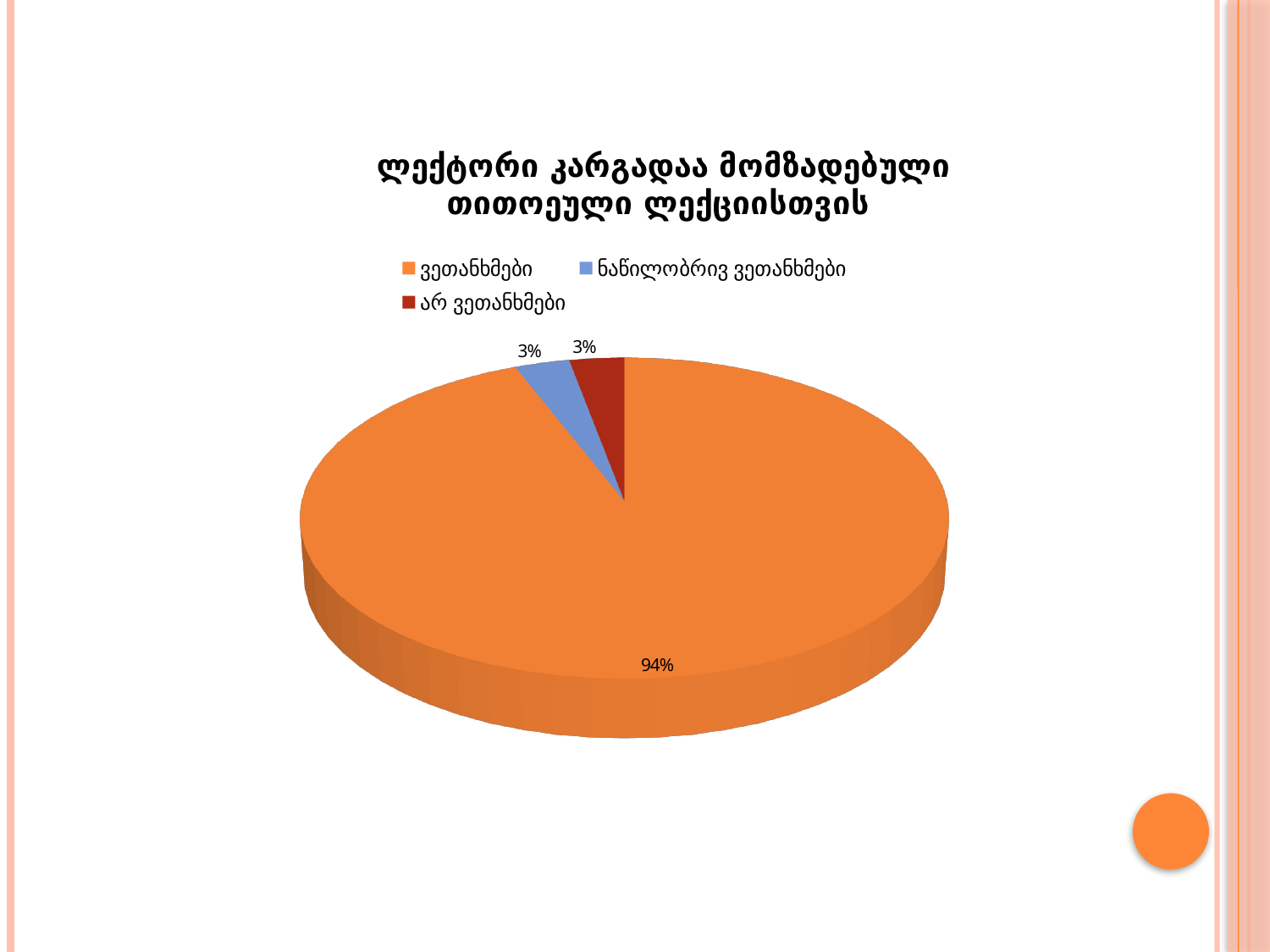
What kind of chart is shown on the slide? pie chart What is the difference between the share for ვეთანხმები and the share for არ ვეთანხმები? 91% How many slices does the pie chart have? 3 Which is larger, the share for ვეთანხმები or the share for ნაწილობრივ ვეთანხმები? ვეთანხმები What share of the pie does ნაწილობრივ ვეთანხმები take? 3% Which category has the largest slice of the pie? ვეთანხმები What share of the pie does არ ვეთანხმები take? 3% How many entries does the legend list? 3 What colour is the slice for ვეთანხმები? orange What is the title of the chart? ლექტორი კარგადაა მომზადებული თითოეული ლექციისთვის What is the combined share of ნაწილობრივ ვეთანხმები and არ ვეთანხმები? 6% What share of the pie does ვეთანხმები take? 94%